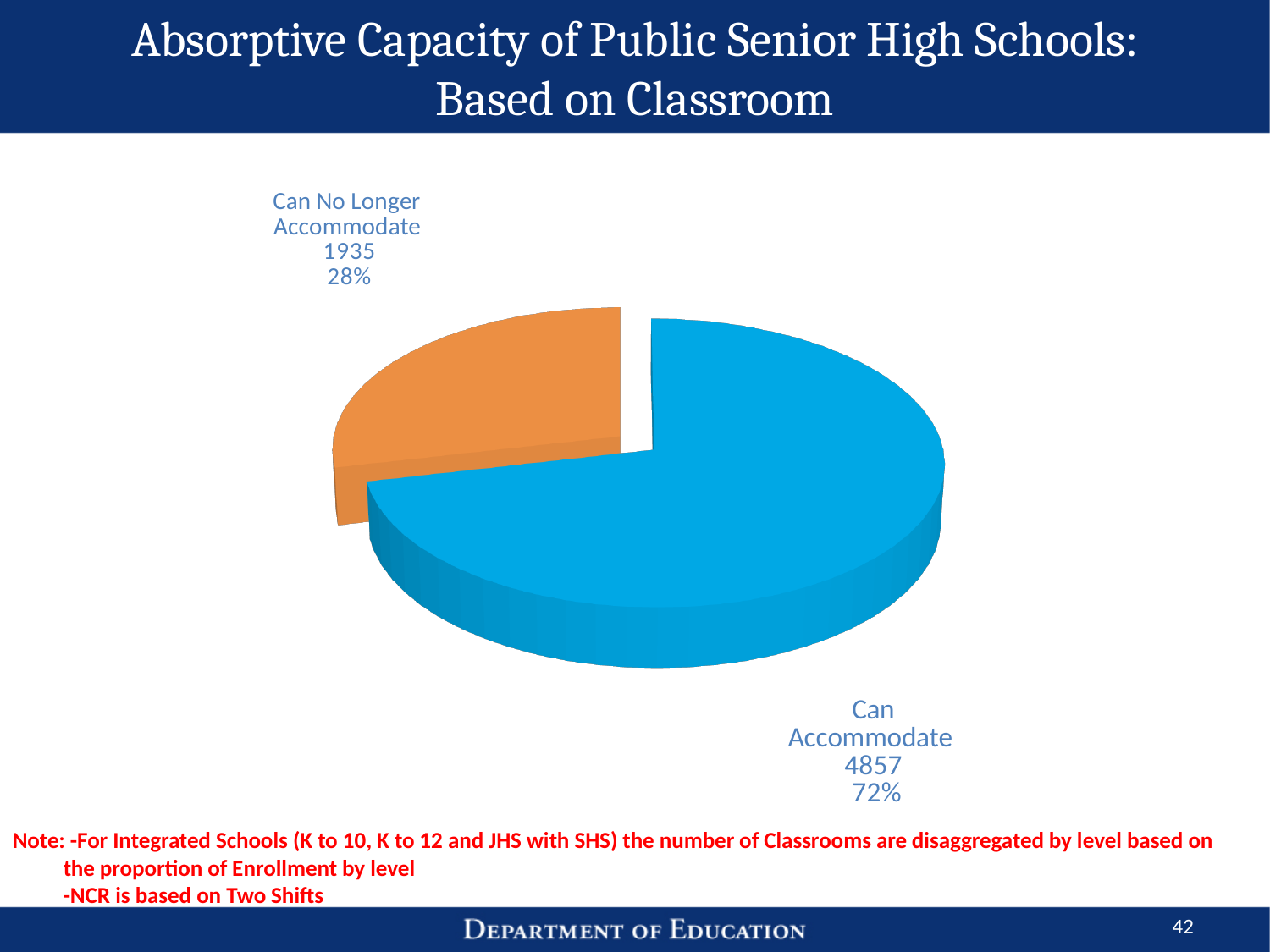
What is the value for Can Accommodate? 4857 What kind of chart is shown on the slide? pie chart Which category has the smallest slice? Can No Longer Accommodate What is the total of the two slices in the pie chart? 6792 What share of the pie does Can Accommodate represent? 72% Which category has the largest slice? Can Accommodate What share of the pie does Can No Longer Accommodate represent? 28% What colour is the Can No Longer Accommodate slice? orange Which is larger, Can Accommodate or Can No Longer Accommodate? Can Accommodate What is the difference between the values for Can Accommodate and Can No Longer Accommodate? 2922 What is the value for Can No Longer Accommodate? 1935 How many slices does the pie chart have? 2